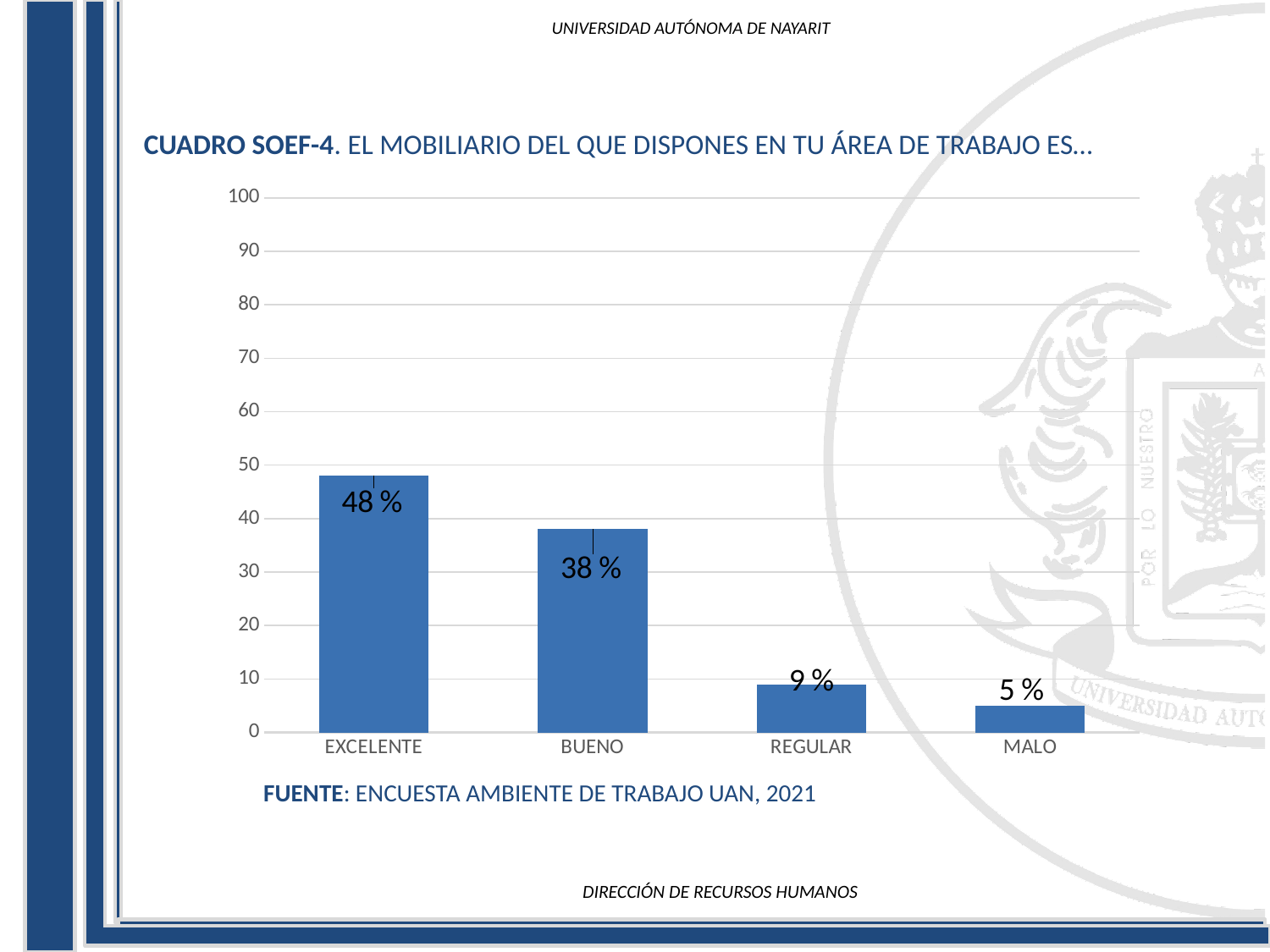
What is the value for EXCELENTE? 48 % What is the value for MALO? 5 % Do the values rise or fall from left to right along the x axis? fall What is the value for REGULAR? 9 % Is the value for BUENO greater or less than 40? less Which category has the lowest value? MALO Which is larger, the value for REGULAR or the value for MALO? REGULAR How many categories are shown on the x axis? 4 What is the difference between the values for EXCELENTE and BUENO? 10 % What is the value for BUENO? 38 % What kind of chart is shown on the slide? bar chart Which category has the highest value? EXCELENTE